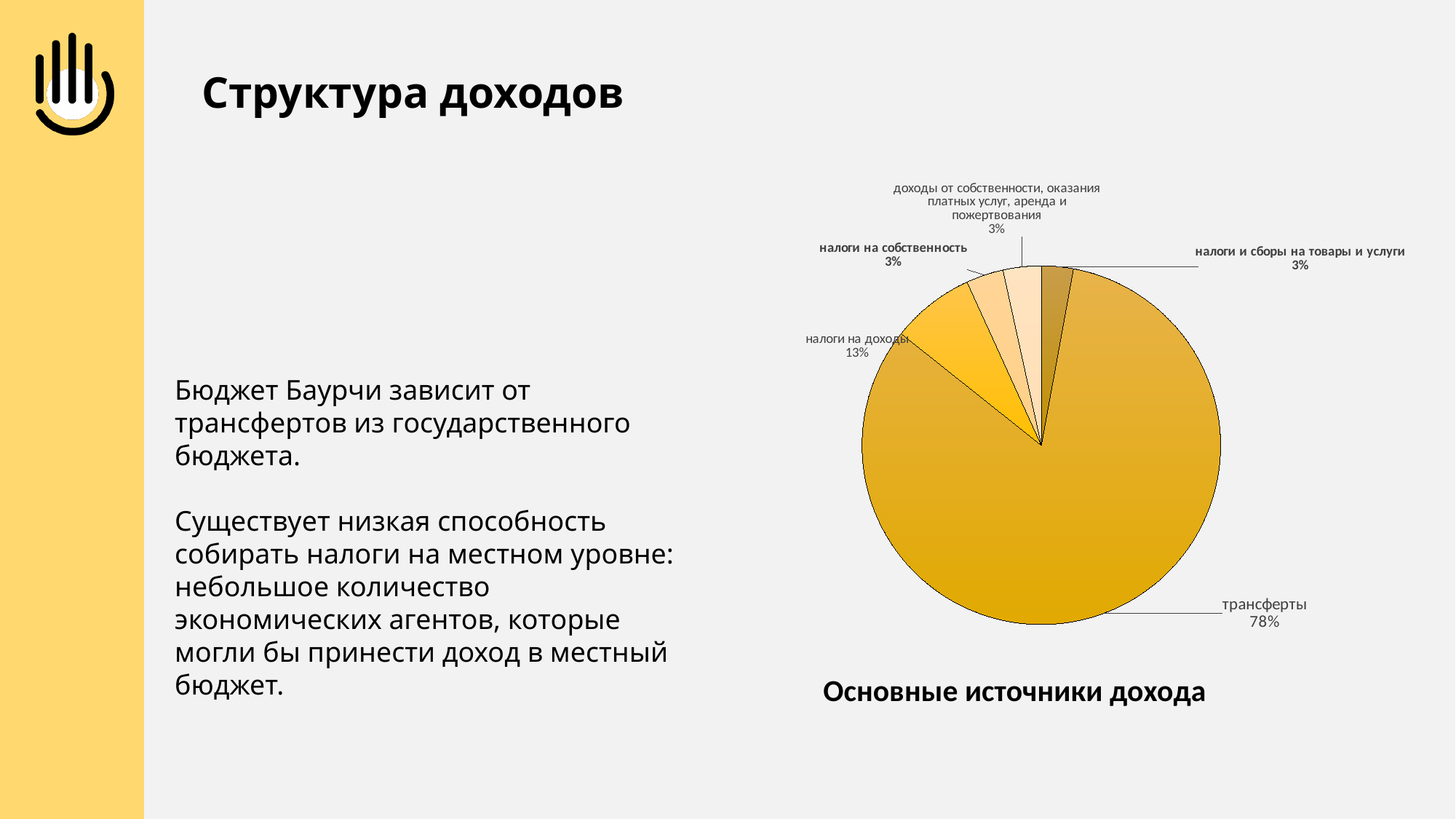
Which category has the largest share of the pie? трансферты What is the title of the chart? Основные источники дохода What share of the pie does доходы от собственности, оказания платных услуг, аренда и пожертвования account for? 3% Which is larger: the share for налоги на доходы or the share for налоги на собственность? налоги на доходы What share of the pie does налоги на собственность account for? 3% What is the difference in share between трансферты and налоги на доходы? 65% What share of the pie does налоги и сборы на товары и услуги account for? 3% How many slices does the pie chart have? 5 What is the combined share of трансферты and налоги на доходы? 91% What type of chart is shown on the slide? pie chart